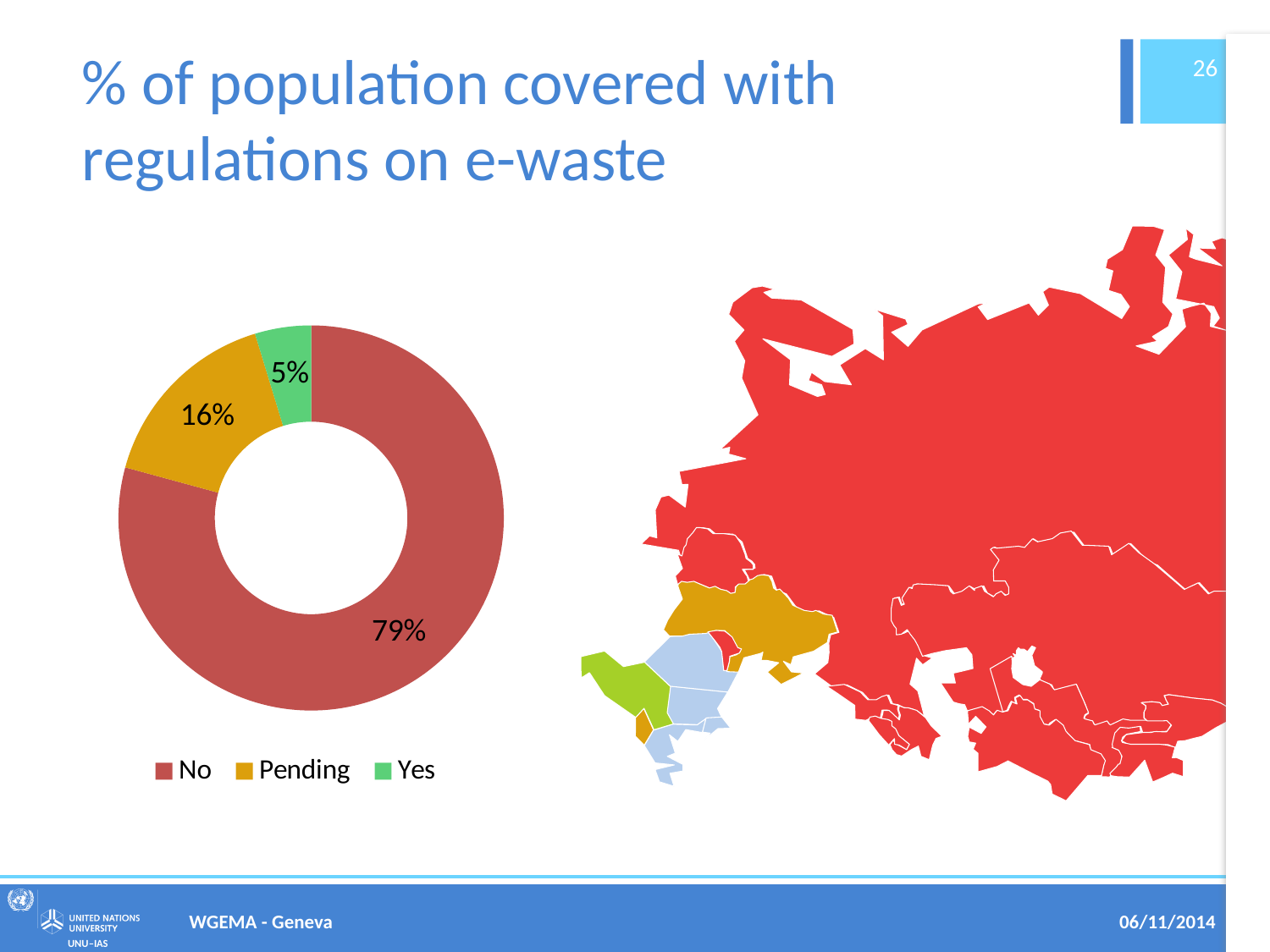
What type of chart is shown on the left of the slide? Doughnut chart Which category has the largest share in the doughnut chart? No What is the title of the slide containing the doughnut chart? % of population covered with regulations on e-waste How many categories does the doughnut chart show? 3 What is the difference in percentage points between the 'Pending' and 'Yes' slices? 11 Which category has the smallest share in the doughnut chart? Yes What colour represents the 'Pending' category in the doughnut chart? Orange Which is larger in the doughnut chart, 'Pending' or 'Yes'? Pending What is the difference in percentage points between the 'No' and 'Pending' slices? 63 What percentage of the population is covered by the 'No' category in the doughnut chart? 79% What percentage does the 'Pending' slice show in the doughnut chart? 16% What percentage does the 'Yes' slice show in the doughnut chart? 5%